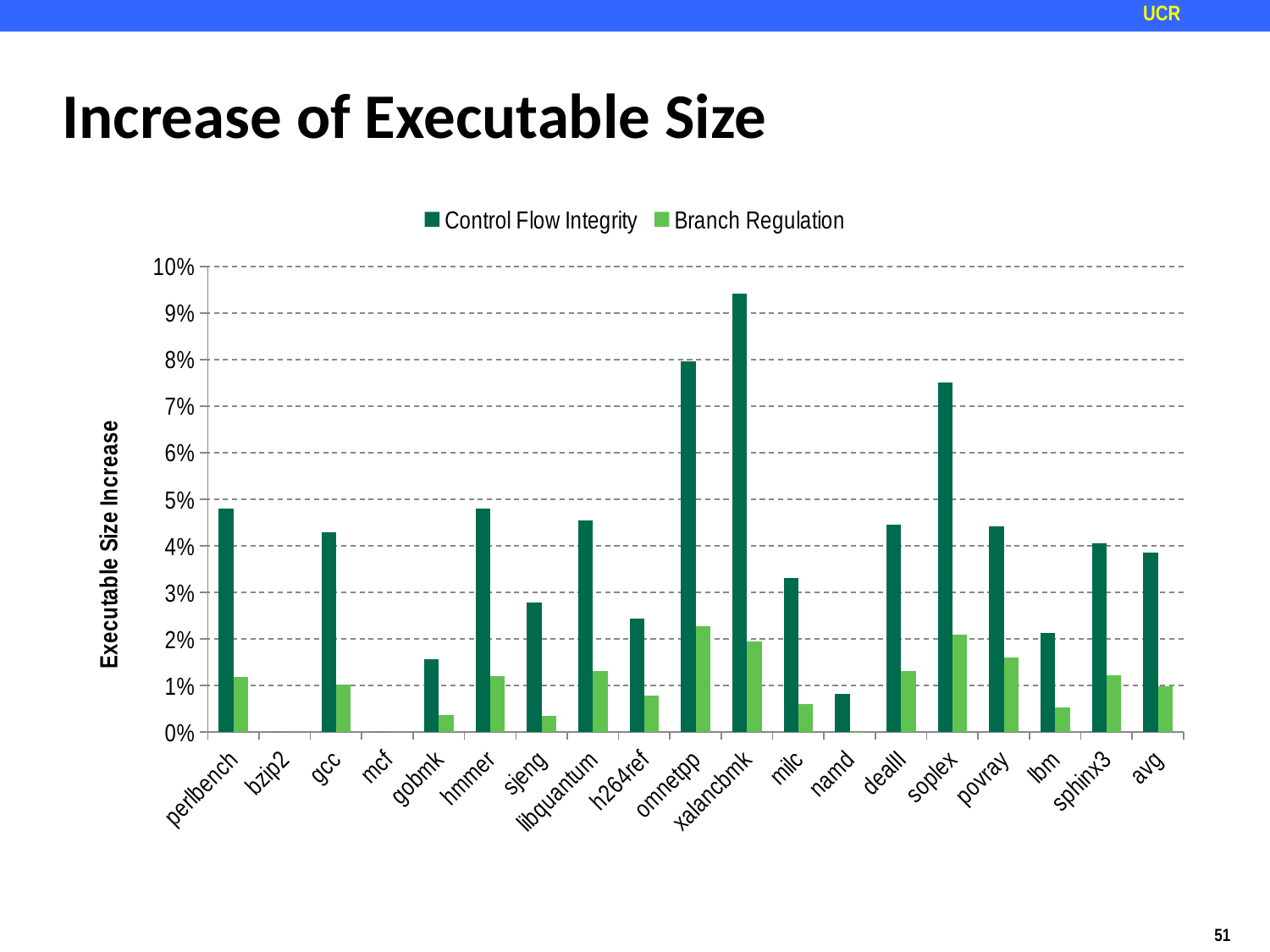
What are the two series named in the legend? Control Flow Integrity and Branch Regulation Is the Control Flow Integrity value for milc greater or less than 3%? greater How many categories are shown on the x axis? 19 Is the Branch Regulation value for omnetpp greater or less than 2%? greater How many series does the legend list? 2 Is the Control Flow Integrity value for xalancbmk greater or less than 9%? greater What kind of chart is shown on the slide? bar chart Which has the larger Branch Regulation value, omnetpp or h264ref? omnetpp Which has the larger Control Flow Integrity value, hmmer or sjeng? hmmer Which category has the highest Control Flow Integrity value? xalancbmk